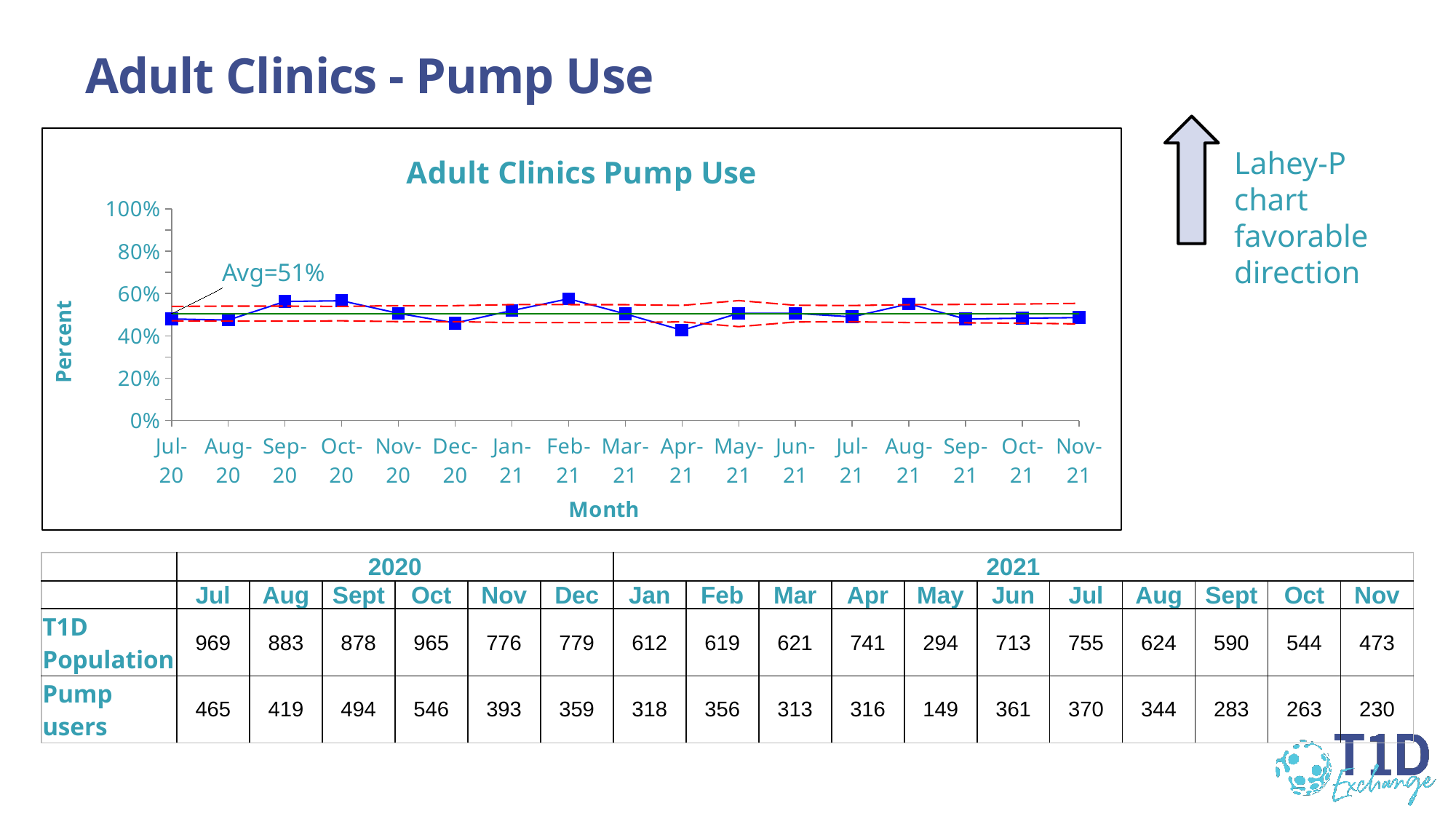
Is the value for Apr-21 greater or less than 60%? less What kind of chart is shown on the slide? line chart How many monthly data points are plotted on the chart? 17 What is the title of the chart? Adult Clinics Pump Use What is the first month shown on the x axis? Jul-20 Is the value for Sep-20 greater or less than 20%? greater What is the label of the y axis? Percent Is the value for Feb-21 greater or less than 40%? greater Which month has the lowest plotted pump use percentage? Apr-21 What average value is annotated on the chart? Avg=51% Which is larger, the value for Feb-21 or the value for Apr-21? Feb-21